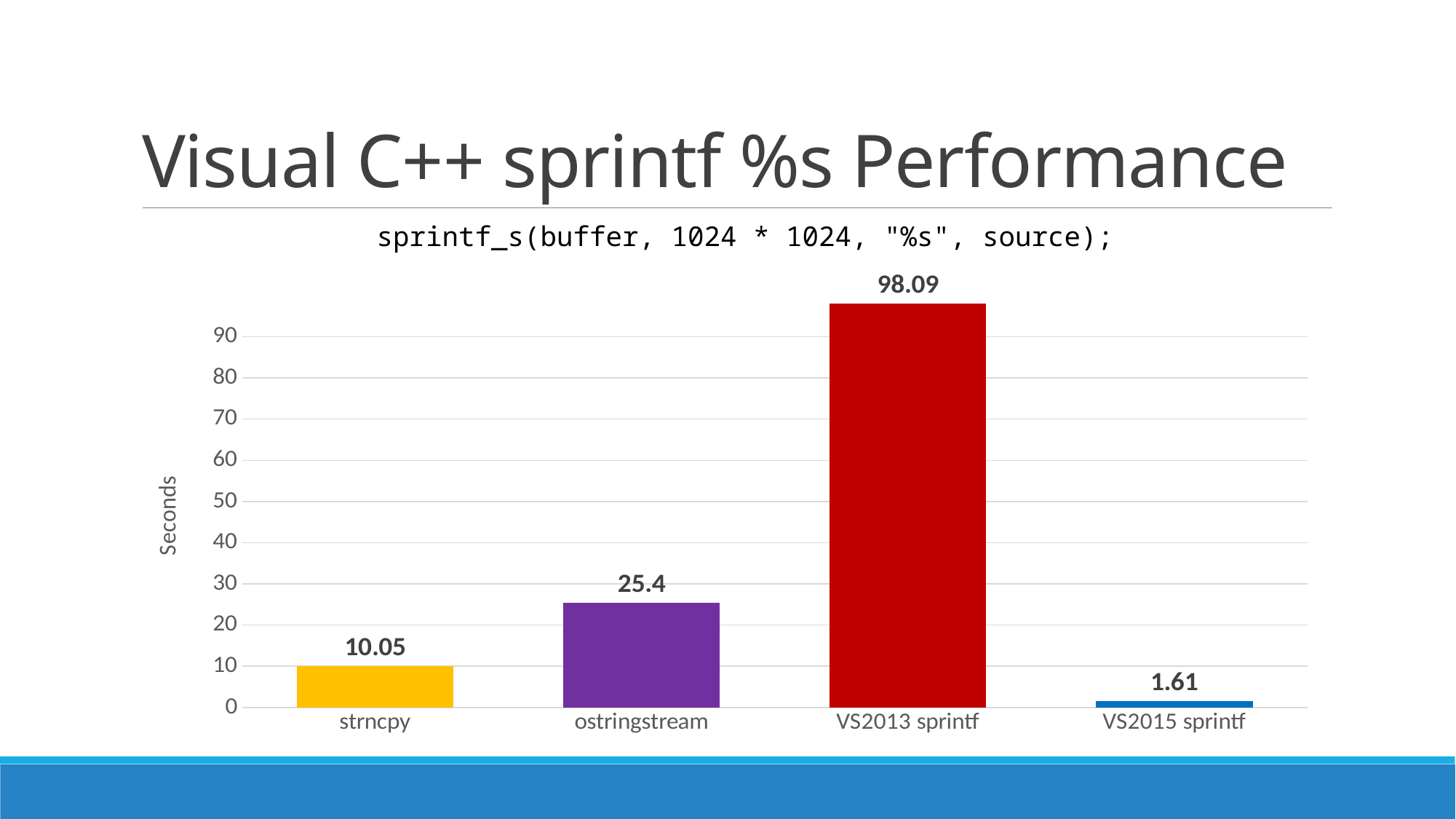
What is the label of the vertical axis? Seconds Which is larger, the value for ostringstream or the value for strncpy? ostringstream What is the value for VS2013 sprintf? 98.09 What is the value for strncpy? 10.05 What is the value for VS2015 sprintf? 1.61 What kind of chart is shown on the slide? bar chart What is the difference between the values for VS2013 sprintf and VS2015 sprintf? 96.48 Which category has the lowest value? VS2015 sprintf What is the difference between the values for ostringstream and strncpy? 15.35 What is the value for ostringstream? 25.4 Which category has the highest value? VS2013 sprintf How many categories are shown in the chart? 4